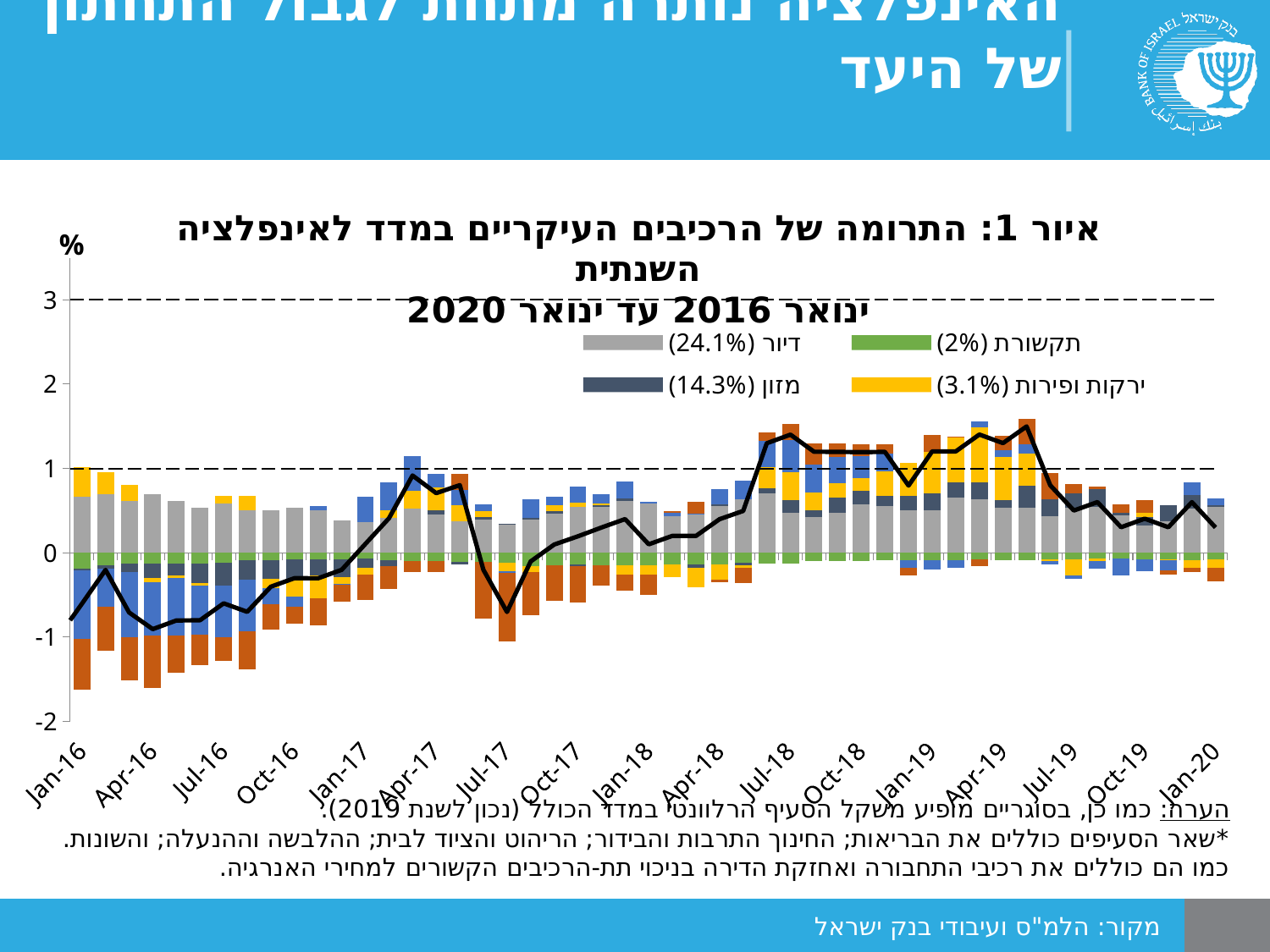
What percentage is shown next to the legend entry מזון? 14.3% Is the value of the black line at Jul-18 greater or less than 1? greater Which is larger, the value of the black line at Jul-18 or at Jan-16? Jul-18 Is the value of the black line at Jul-17 greater or less than 0? less What kind of chart is shown on the slide? Stacked bar chart with a line Is the value of the black line at Jan-20 greater or less than 1? less What is the highest value shown on the y axis? 3 How many date labels are shown on the x axis? 17 Does the black line rise or fall between Jul-19 and Oct-19? fall What percentage is shown next to the legend entry דיור? 24.1%